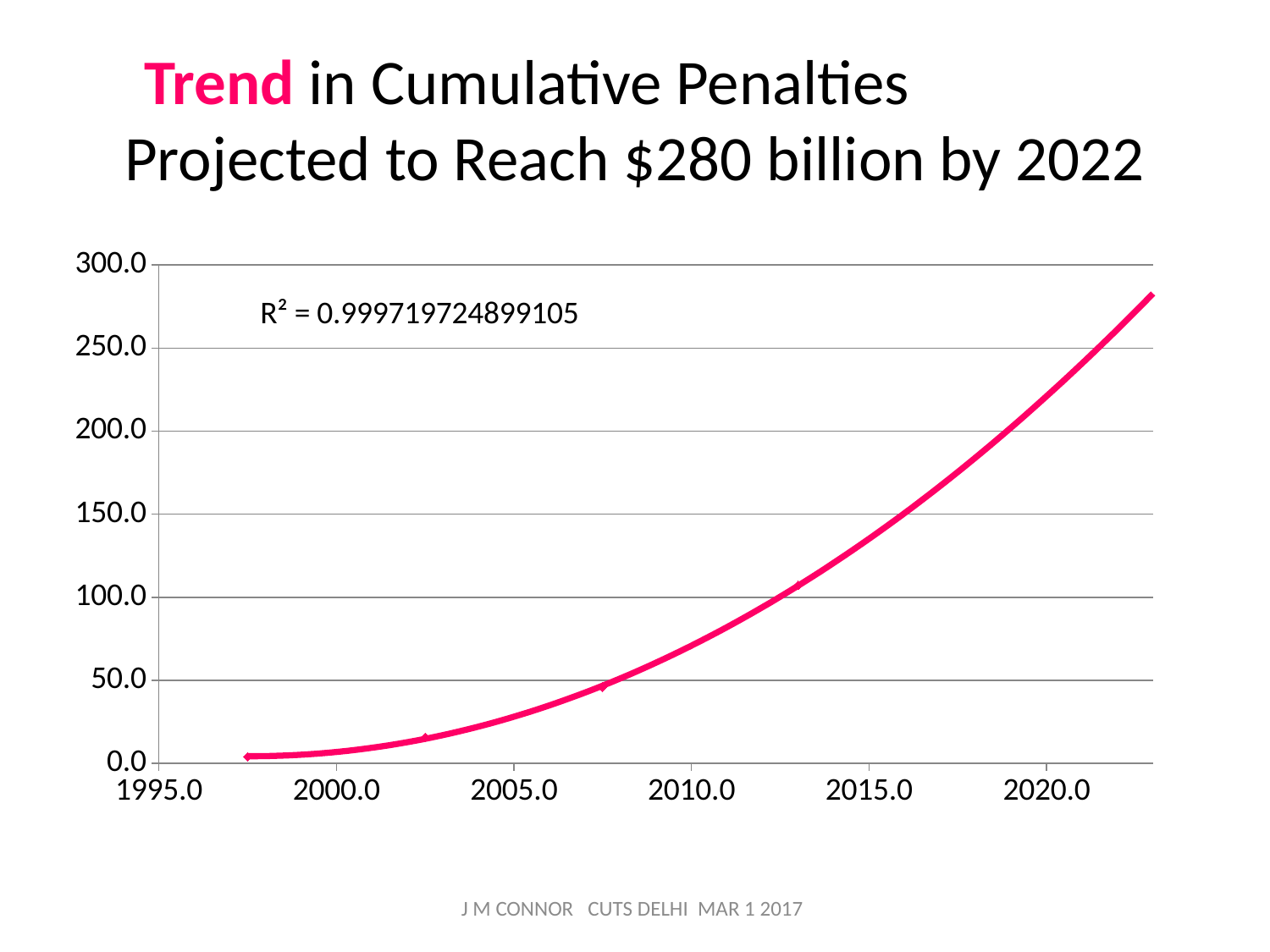
What R² value is printed on the chart? R² = 0.999719724899105 What is the highest tick value shown on the y axis of the chart? 300.0 Do the values on the chart rise or fall as the year increases along the x axis? rise Is the value of the curve at 2005.0 greater or less than 50? less Is the value of the curve at 2015.0 greater or less than 100? greater What kind of chart is shown on the slide? line chart Is the value of the curve at 2010.0 greater or less than 50? greater